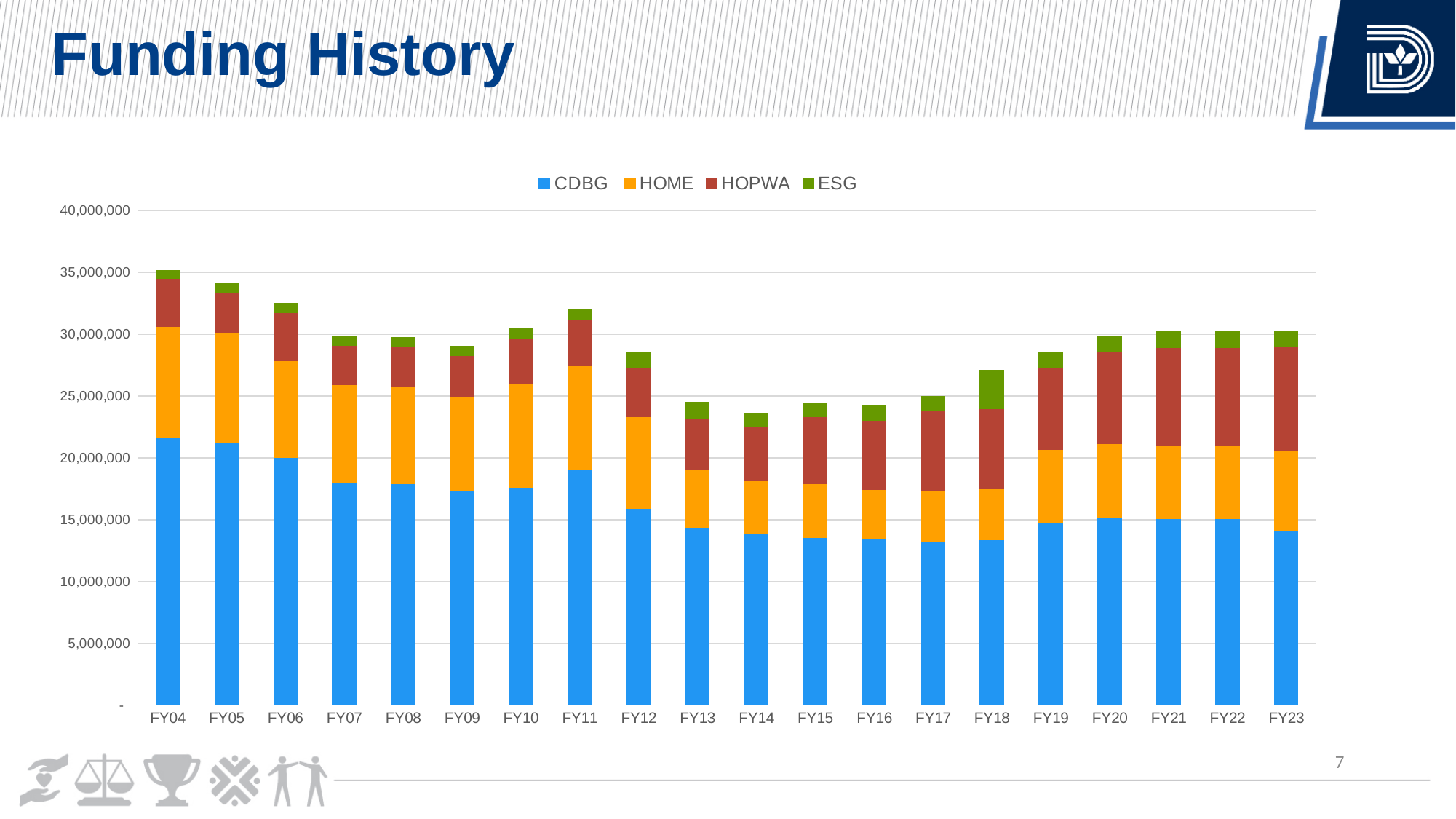
What kind of chart is shown on the slide? stacked bar chart Which fiscal year has the highest total funding? FY04 Which series is shown in blue in the legend? CDBG Is the total funding for FY12 greater or less than 30,000,000? less How many fiscal years are shown on the x axis? 20 Is the CDBG value for FY14 greater or less than 15,000,000? less Is the total funding for FY18 greater or less than 25,000,000? greater Which is larger, the total funding for FY04 or for FY14? FY04 Which is larger, the CDBG value for FY04 or for FY23? FY04 Does the CDBG funding generally rise or fall from FY04 to FY14? fall How many series does the legend list? 4